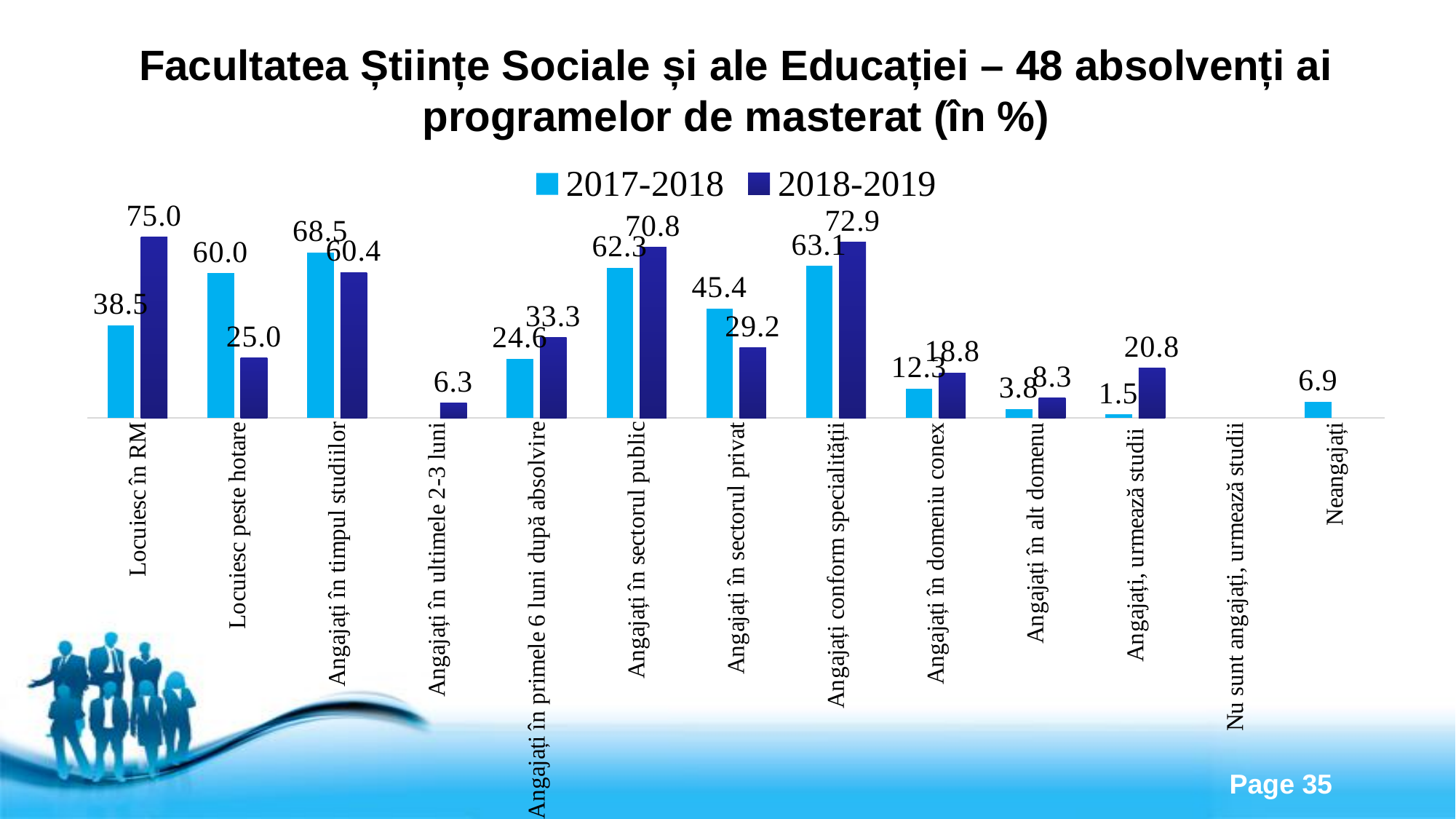
How many categories are shown on the x axis of the chart? 13 What is the difference between the 2017-2018 and 2018-2019 values for 'Locuiesc peste hotare'? 35.0 How many series does the legend list? 2 Which category has the highest value in the 2018-2019 series? Locuiesc în RM Which category has the lowest value in the 2017-2018 series? Angajați, urmează studii What is the difference between the 2018-2019 and 2017-2018 values for 'Locuiesc în RM'? 36.5 What is the value for 'Locuiesc în RM' in the 2018-2019 series? 75.0 What is the value for 'Angajați în sectorul privat' in the 2017-2018 series? 45.4 Which is larger for 'Angajați în timpul studiilor': the 2017-2018 value or the 2018-2019 value? 2017-2018 What kind of chart is shown on the slide? Bar chart What is the value for 'Angajați, urmează studii' in the 2018-2019 series? 20.8 Which is larger for 'Angajați conform specialității': the 2017-2018 value or the 2018-2019 value? 2018-2019